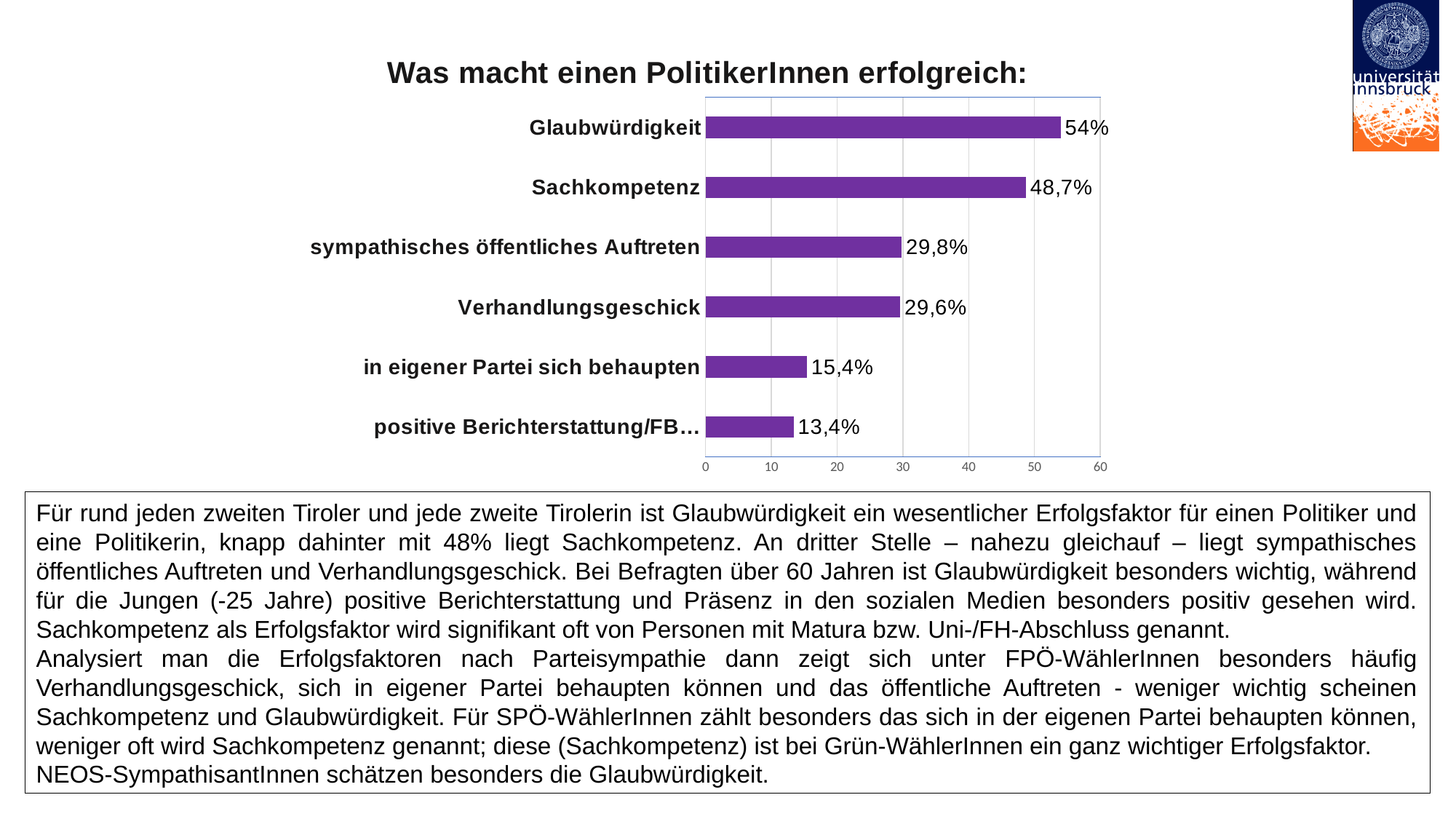
What is the difference between the values for sympathisches öffentliches Auftreten and Verhandlungsgeschick? 0,2% Which category has the highest value? Glaubwürdigkeit What kind of chart is shown on the slide? bar chart What is the value for Verhandlungsgeschick? 29,6% How many categories are shown in the chart? 6 Which category has the lowest value? positive Berichterstattung/FB… What is the value for in eigener Partei sich behaupten? 15,4% What is the value for Sachkompetenz? 48,7% What is the difference between the values for Glaubwürdigkeit and Sachkompetenz? 5,3% Is the value for Sachkompetenz greater or less than 50? less Which is larger, the value for Sachkompetenz or the value for Verhandlungsgeschick? Sachkompetenz What is the value for Glaubwürdigkeit? 54%